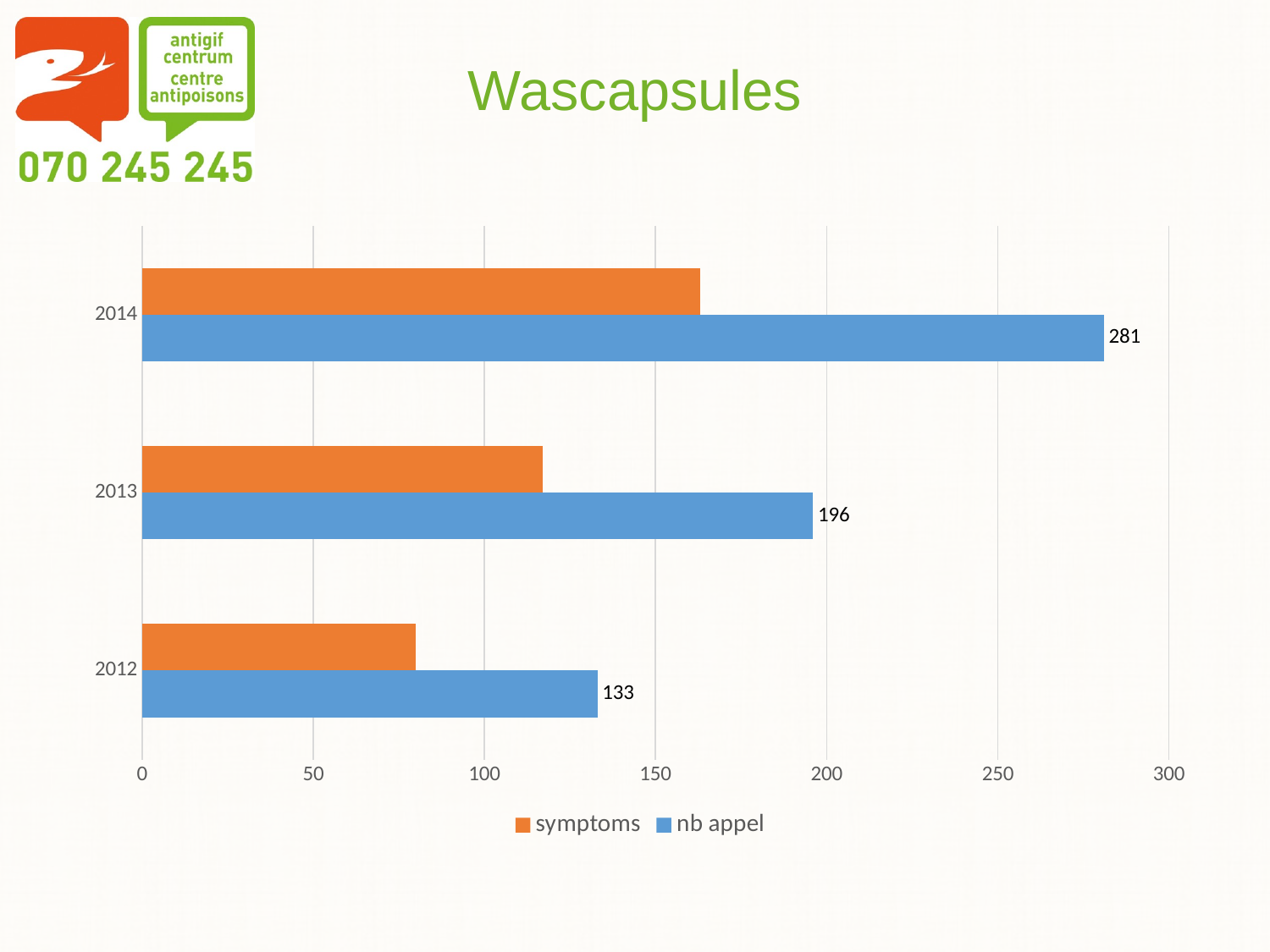
Which is larger for 2013, symptoms or nb appel? nb appel What is the value of nb appel for 2014? 281 What is the difference between the nb appel values for 2014 and 2013? 85 Is the symptoms value for 2012 greater or less than 100? less Is the symptoms value for 2014 greater or less than 150? greater Which year has the lowest nb appel value? 2012 What is the value of nb appel for 2012? 133 Which year has the highest nb appel value? 2014 What is the value of nb appel for 2013? 196 How many series does the legend list? 2 What type of chart is shown on the slide? bar chart What is the difference between the nb appel values for 2013 and 2012? 63